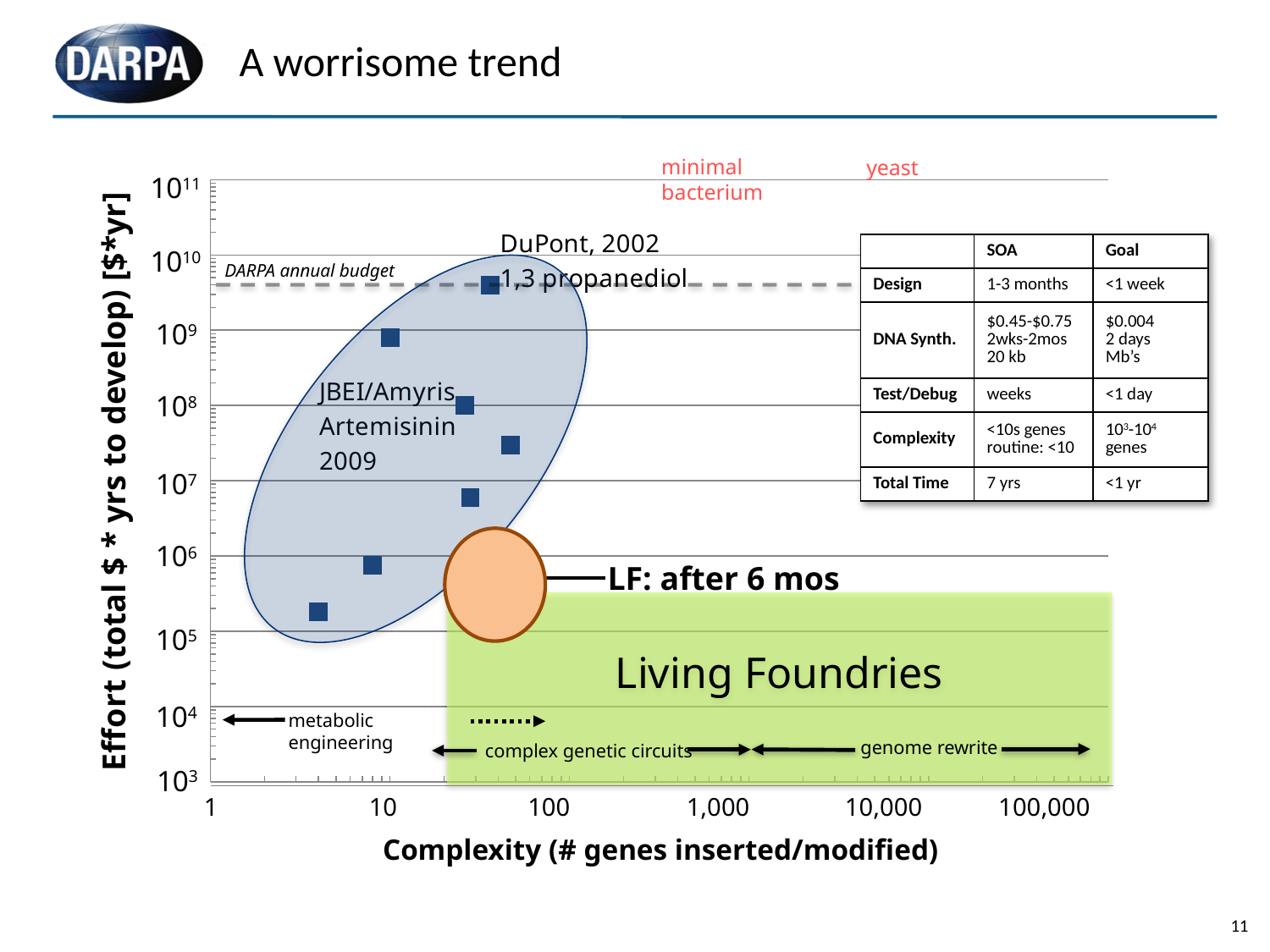
Is the DARPA annual budget dashed line above or below 10^9 on the effort axis? above Is the effort value for the DuPont, 2002 1,3 propanediol point greater or less than 10^9? greater Which has the higher effort value: the DuPont, 2002 1,3 propanediol point or the lowest plotted point near complexity 4? DuPont, 2002 1,3 propanediol What kind of chart is shown on the slide? scatter chart What does the horizontal dashed line on the chart represent? DARPA annual budget Is the effort value for the DuPont, 2002 1,3 propanediol point greater or less than 10^10? less Do the plotted points generally rise or fall in effort as complexity increases along the x axis? rise How many blue square data points are plotted on the chart? 7 What is the title of the x axis of the chart? Complexity (# genes inserted/modified) Which labelled data point has the highest effort value on the chart? DuPont, 2002 1,3 propanediol How many labelled tick values are shown on the x axis of the chart? 6